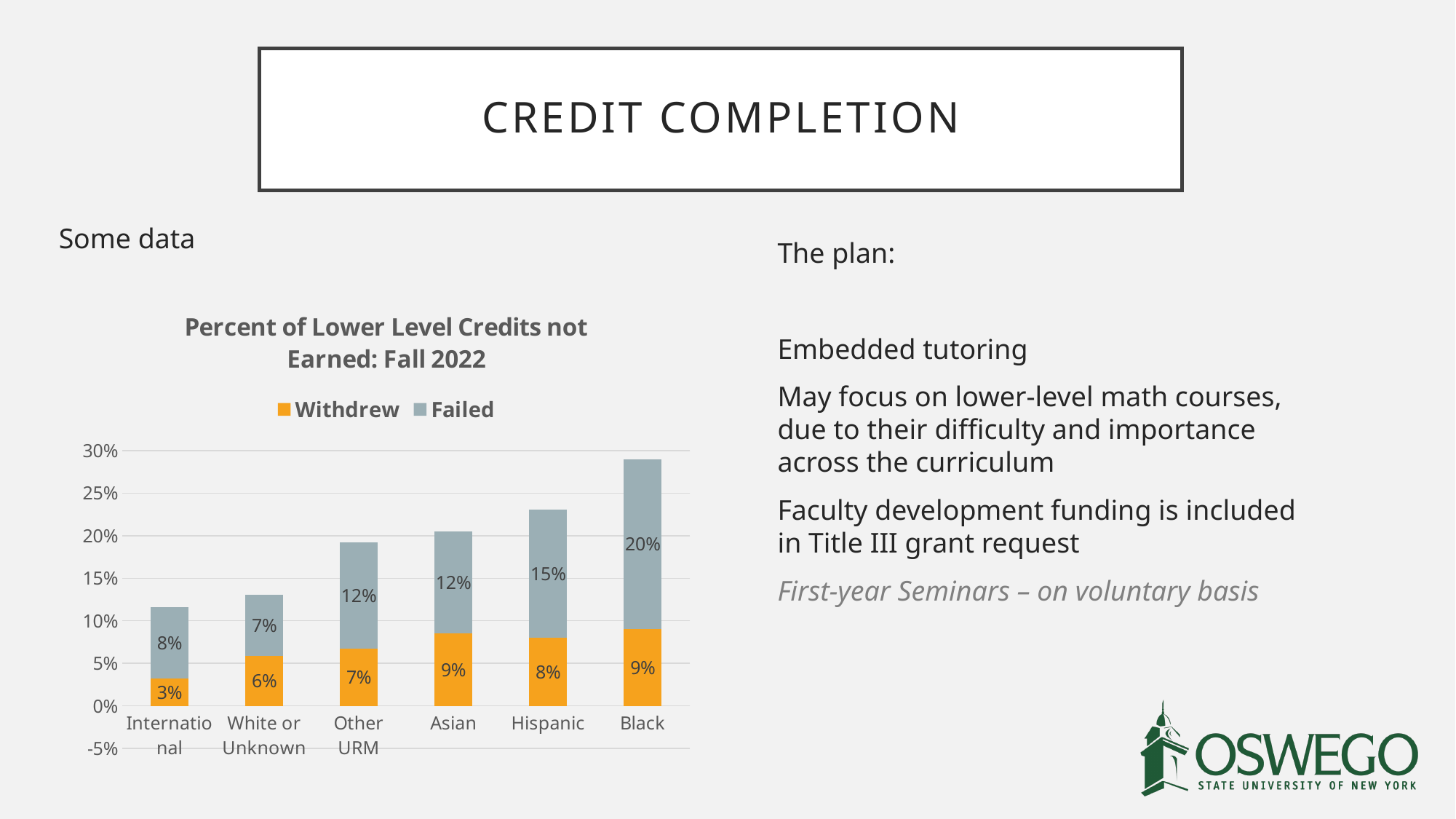
Which category has the lowest Withdrew value? International Do the total bar heights rise or fall from left to right along the x axis? Rise Which has the larger Withdrew value, Asian or Hispanic? Asian What is the Failed value for Black? 20% What is the Withdrew value for International? 3% What is the Failed value for Other URM? 12% Which category has the highest Failed value? Black How many series does the legend list? 2 What is the total of the stacked bar for Black? 29% How many categories are shown on the x axis? 6 What kind of chart is shown on the slide? Stacked bar chart What is the difference between the Failed values for Black and Hispanic? 5%